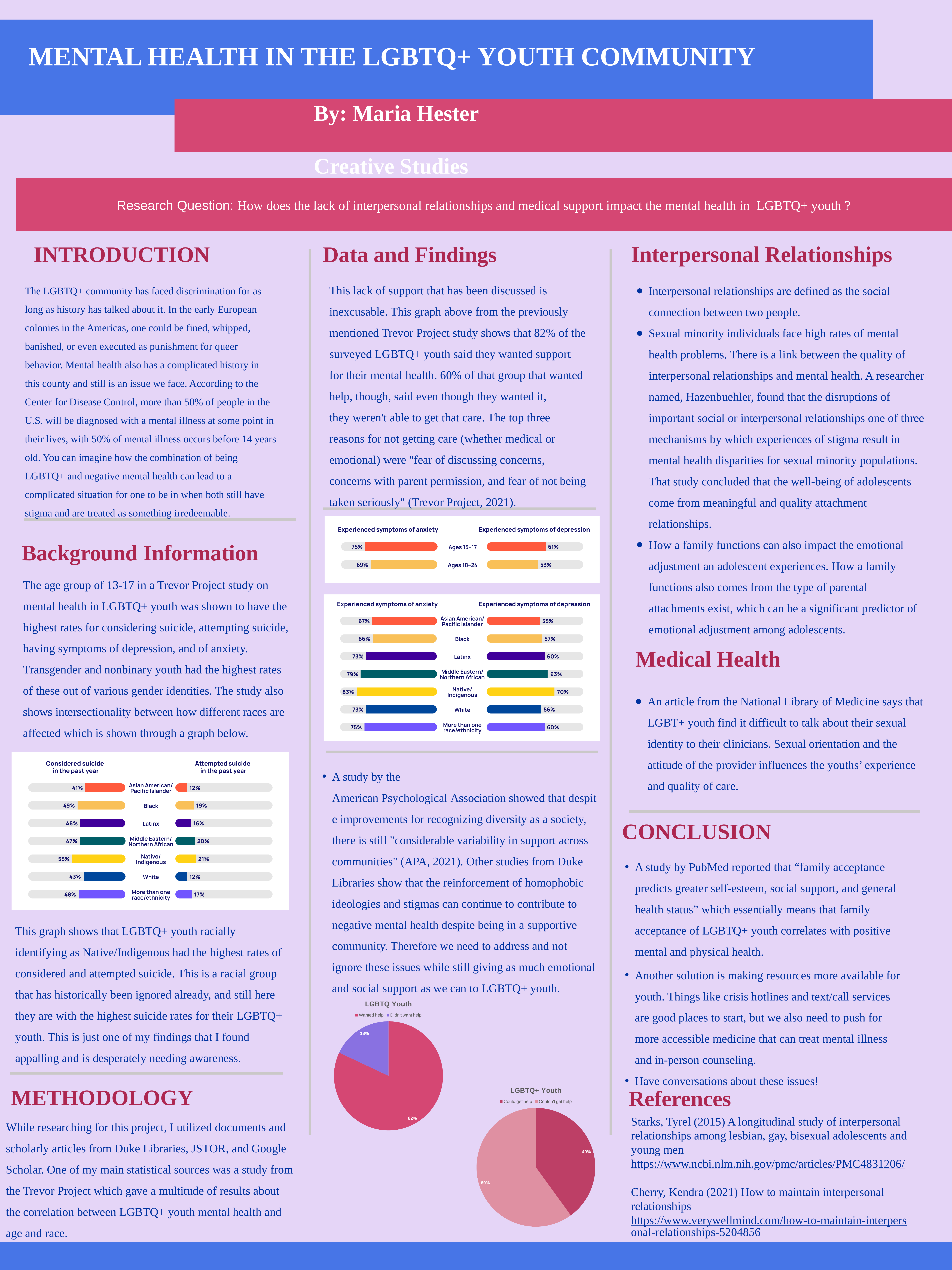
In the 'Attempted suicide in the past year' chart, which racial group has the highest value? Native/Indigenous What kind of chart is the 'LGBTQ Youth' chart showing 'Wanted help' and 'Didn't want help'? Pie chart In the 'Attempted suicide in the past year' chart, what is the difference between the Native/Indigenous value and the White value? 9% In the 'LGBTQ+ Youth' pie chart with the legend 'Could get help' and 'Couldn't get help', what share of the pie is 'Couldn't get help'? 60% In the 'Experienced symptoms of depression' chart by race, which group has the highest value? Native/Indigenous In the 'Experienced symptoms of anxiety' chart by race, what is the value for Middle Eastern/Northern African youth? 79% In the 'Experienced symptoms of anxiety' chart by age group, what is the value for Ages 13-17? 75% How many racial/ethnic categories are shown in the 'Experienced symptoms of anxiety' chart by race? 7 In the 'Considered suicide in the past year' chart, what is the value for Native/Indigenous youth? 55% In the 'Considered suicide in the past year' chart, which racial group has the lowest value? Asian American/Pacific Islander In the 'Experienced symptoms of depression' chart by age group, which age group has the higher value, Ages 13-17 or Ages 18-24? Ages 13-17 In the 'LGBTQ Youth' pie chart with the legend 'Wanted help' and 'Didn't want help', what share of the pie is 'Wanted help'? 82%